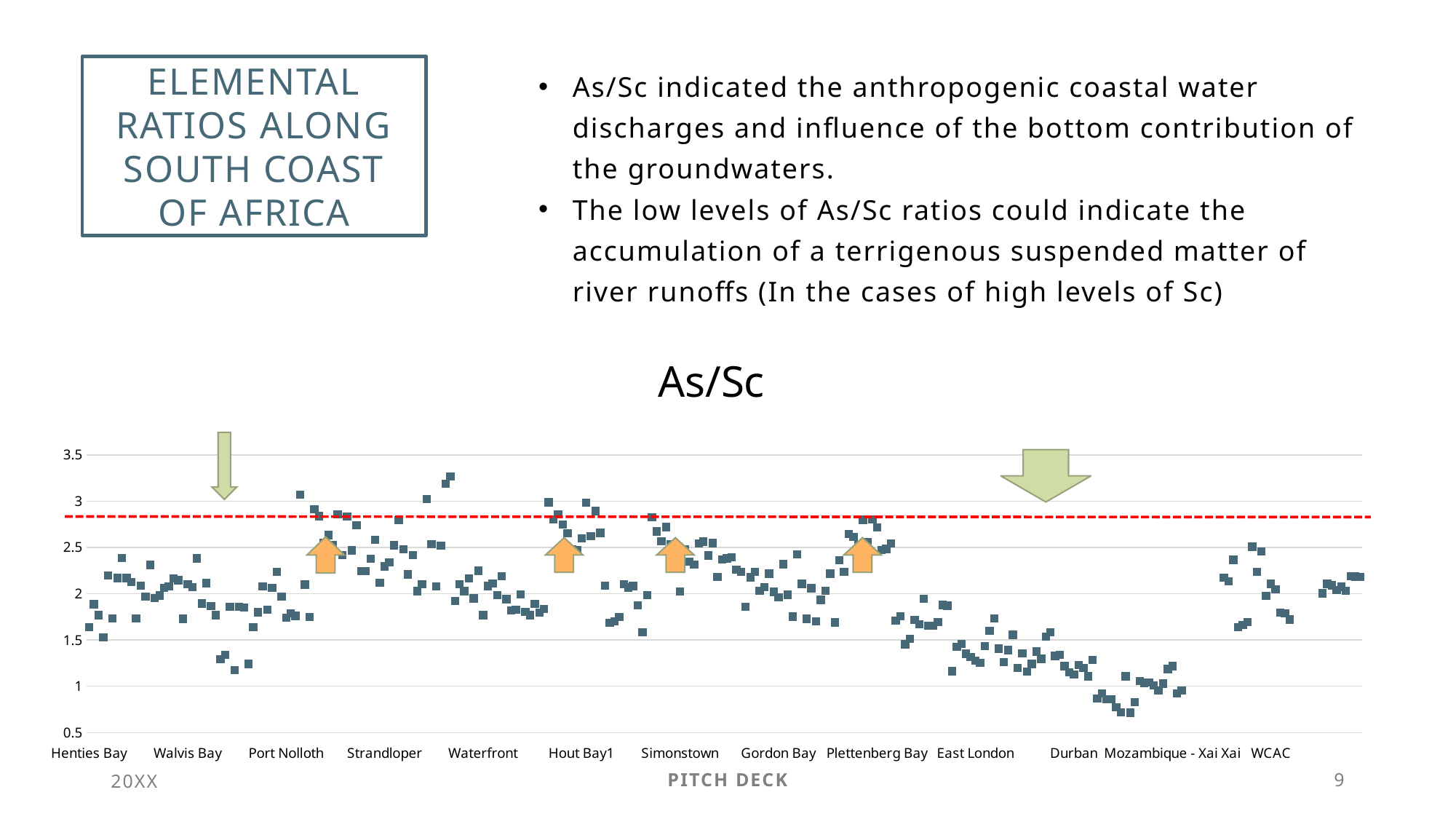
Are the points plotted above the Durban label mostly greater or less than 1.5? less How many location labels are shown along the x axis of the chart? 13 Is the red dashed horizontal line on the chart above or below the 2.5 gridline? above What is the title of the chart? As/Sc Which x-axis label is furthest to the right on the chart? WCAC Is the lowest plotted point on the chart greater or less than 1? less What is the highest tick value shown on the y axis of the chart? 3.5 What type of chart is shown on the slide? scatter chart